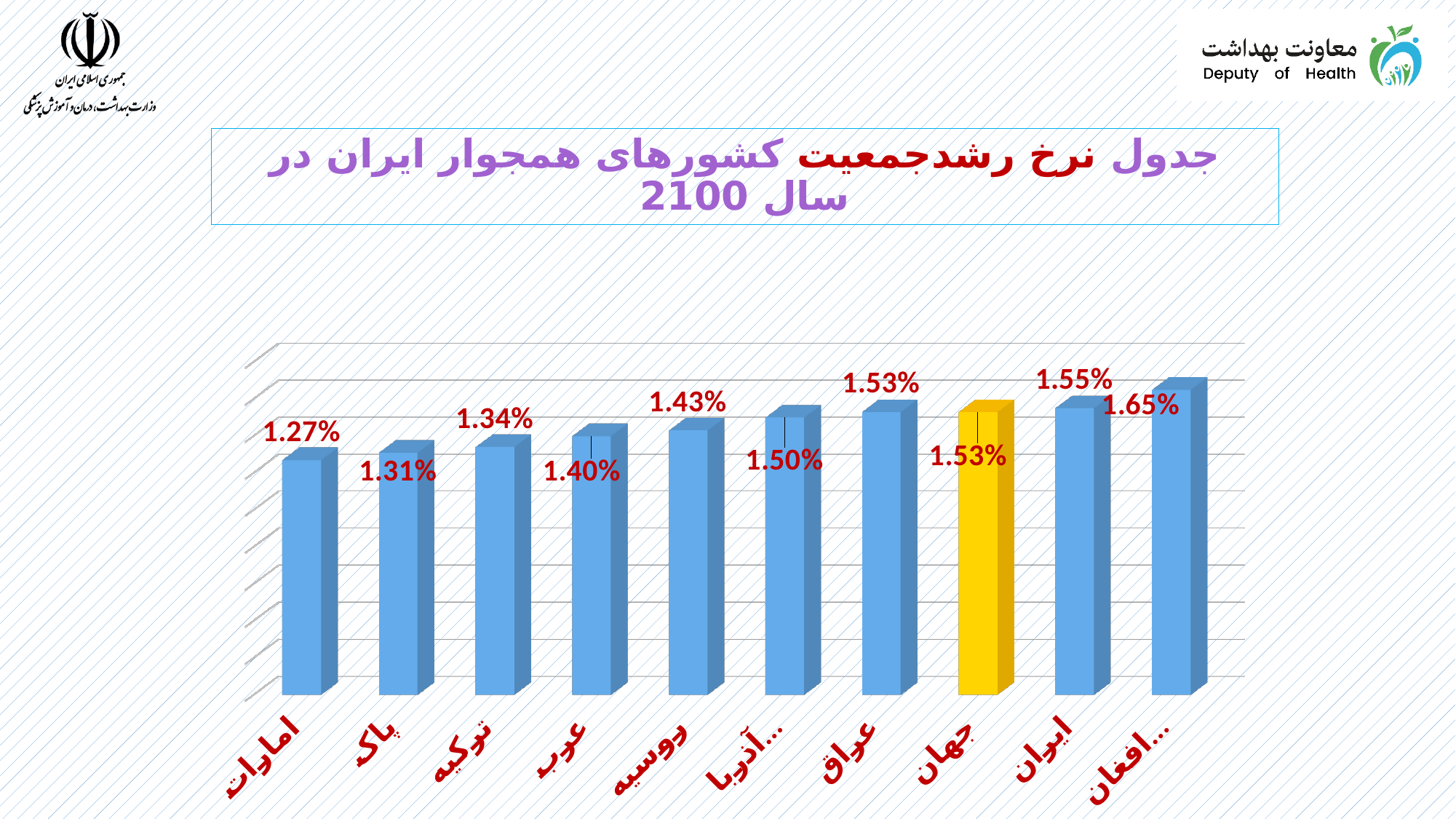
What is the value shown for امارات? 1.27% Which category has the highest value? افغان... Which category has the lowest value? امارات What is the difference between the values for ایران and امارات? 0.28% What is the difference between the values for عرب and ترکیه? 0.06% What is the value shown for ایران? 1.55% What is the value shown for روسیه? 1.43% What kind of chart is shown on the slide? bar chart How many categories are shown on the chart? 10 Which is larger, the value for ایران or the value for عراق? ایران What is the value shown for the yellow bar labelled جهان? 1.53% Which bar is coloured differently (yellow) from the others? جهان